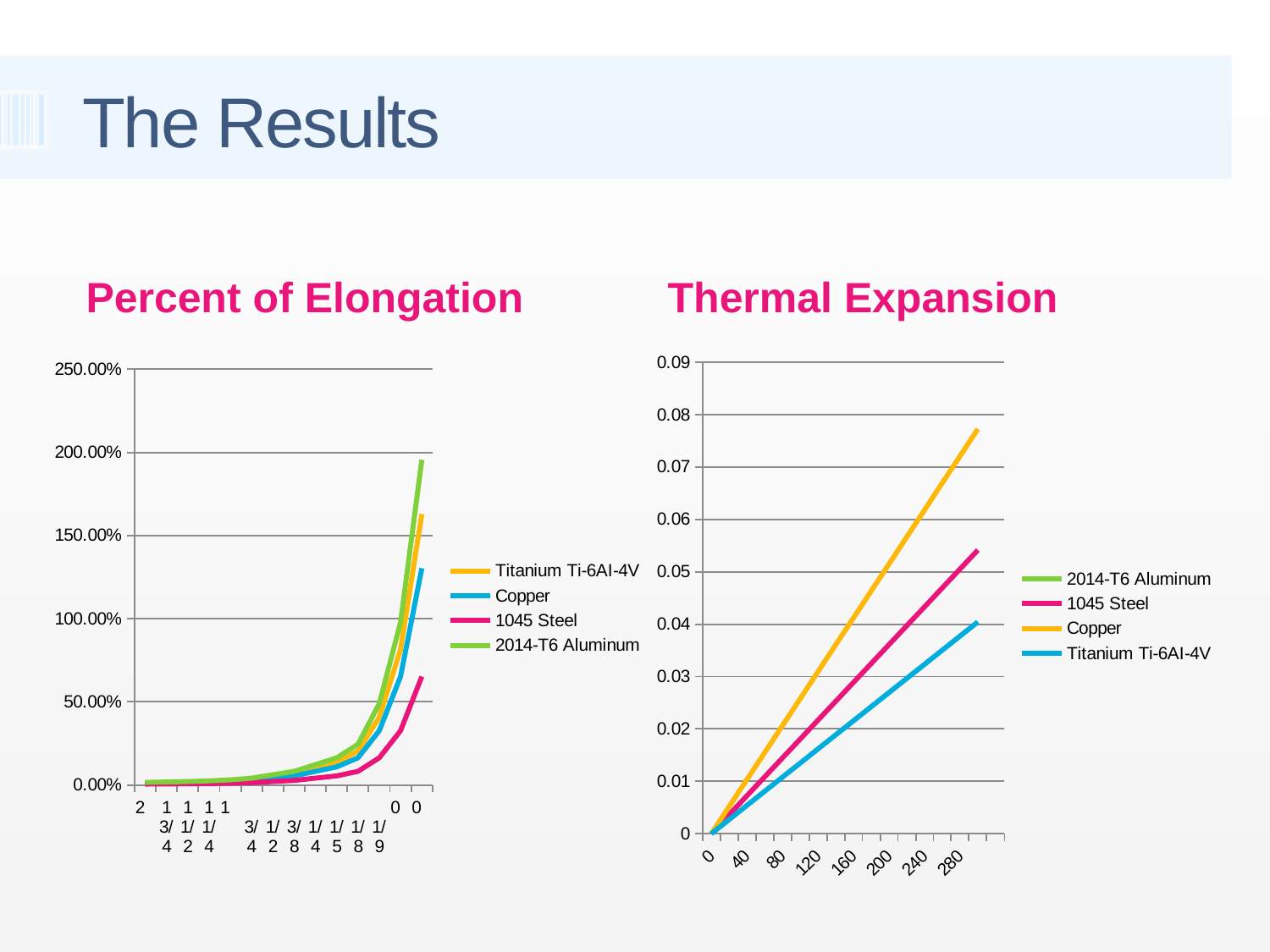
How many series does the legend of the Percent of Elongation chart list? 4 What kind of chart is the Percent of Elongation chart? line chart In the Percent of Elongation chart, which series reaches the highest value at the right end of the x axis? 2014-T6 Aluminum In the Thermal Expansion chart, which is larger at 280: 1045 Steel or Titanium Ti-6Al-4V? 1045 Steel In the Percent of Elongation chart, is the highest value for 1045 Steel greater or less than 100.00%? less In the Percent of Elongation chart, which series reaches the lowest value at the right end of the x axis? 1045 Steel How many series does the legend of the Thermal Expansion chart list? 4 In the Thermal Expansion chart, which plotted line reaches the highest value at 280? Copper In the Thermal Expansion chart, do the plotted values rise or fall as the x axis increases from 0 to 280? rise In the Percent of Elongation chart, is the highest value for Copper greater or less than 100.00%? greater In the Thermal Expansion chart, is the value for Titanium Ti-6Al-4V at 280 greater or less than 0.05? less